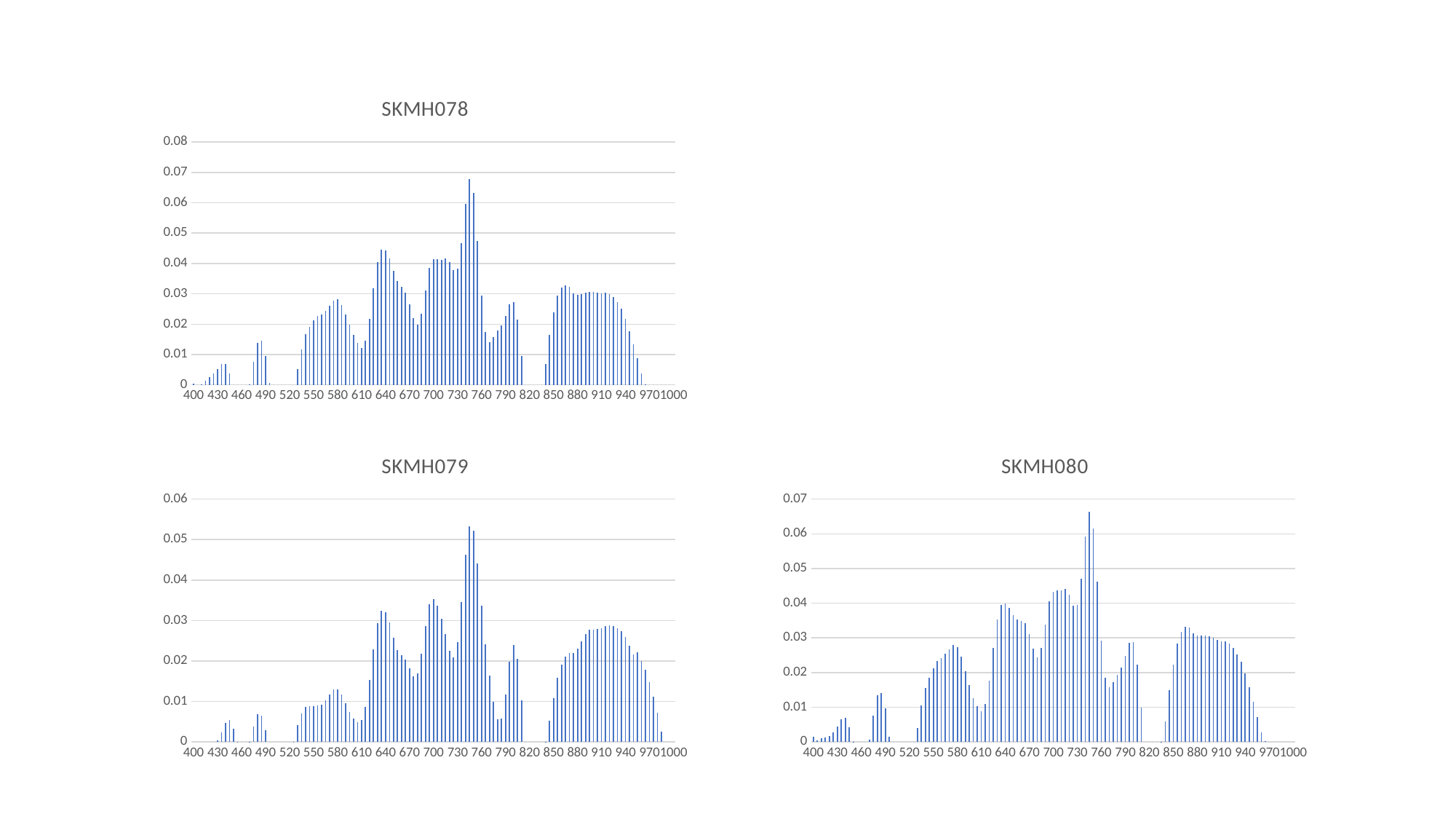
Which chart has the taller peak bar, SKMH078 or SKMH079? SKMH078 In the SKMH079 chart, is the value at 910 greater or less than 0.02? greater In the SKMH079 chart, is the tallest bar greater or less than 0.05? greater In the SKMH078 chart, is the value at 640 greater or less than 0.03? greater How many charts are shown on the slide? 3 What kind of chart is SKMH078? bar chart What is the first value labelled on the horizontal axis of the SKMH080 chart? 400 What is the highest value shown on the vertical axis of the SKMH078 chart? 0.08